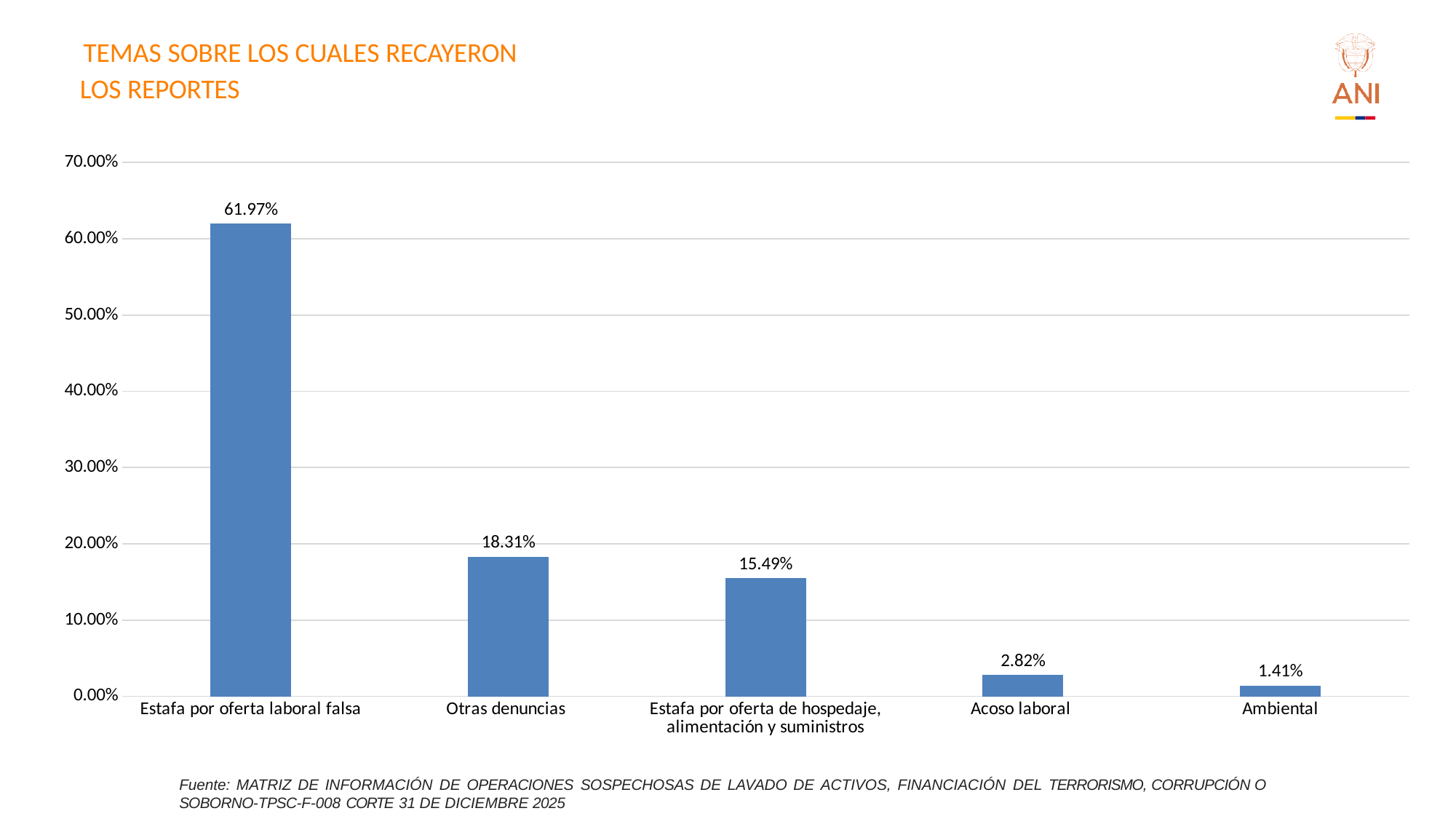
What is the difference between the values for Otras denuncias and Estafa por oferta de hospedaje, alimentación y suministros? 2.82% What is the value for Estafa por oferta de hospedaje, alimentación y suministros? 15.49% What is the value for Ambiental? 1.41% How many categories are shown in the chart? 5 Which category has the highest value? Estafa por oferta laboral falsa What is the value for Acoso laboral? 2.82% What is the value for Otras denuncias? 18.31% Which category has the lowest value? Ambiental What is the value for Estafa por oferta laboral falsa? 61.97% What is the title of the chart? TEMAS SOBRE LOS CUALES RECAYERON LOS REPORTES Which is larger, the value for Acoso laboral or the value for Ambiental? Acoso laboral What kind of chart is shown on the slide? Bar chart